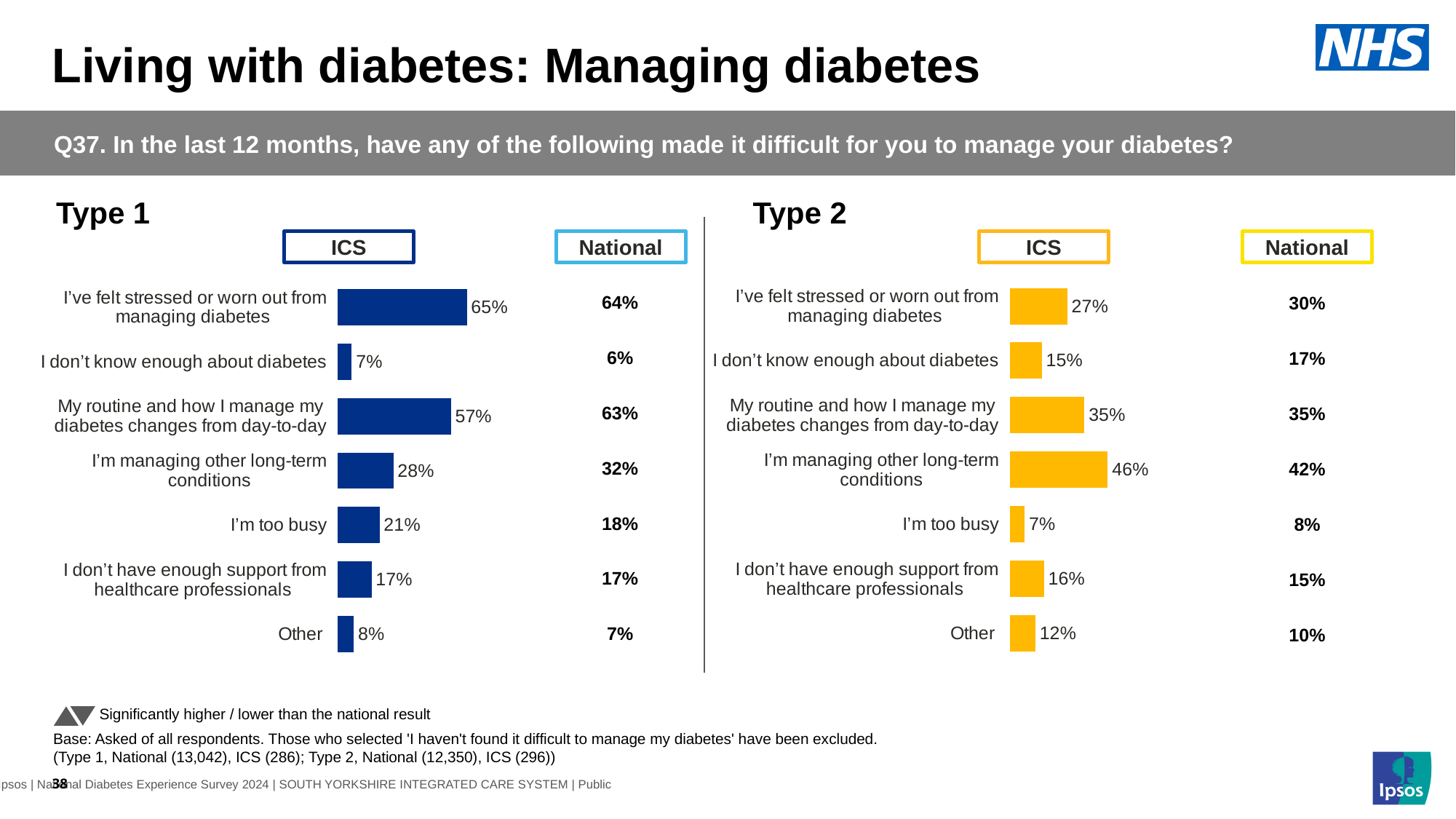
In the Type 1 chart, what is the ICS value for "I've felt stressed or worn out from managing diabetes"? 65% In the Type 2 chart, which category has the highest ICS value? I'm managing other long-term conditions In the Type 2 chart, which category has the lowest ICS value? I'm too busy In the Type 1 chart, what is the National value for "My routine and how I manage my diabetes changes from day-to-day"? 63% What colour are the ICS bars in the Type 2 chart? yellow What type of chart is used for the Type 2 ICS results? bar chart In the Type 2 chart, what is the ICS value for "I'm managing other long-term conditions"? 46% In the Type 2 chart, is the ICS value for "I've felt stressed or worn out from managing diabetes" larger or smaller than the National value? smaller In the Type 2 chart, what is the National value for "I'm too busy"? 8% How many categories are shown in the Type 1 chart? 7 In the Type 1 chart, what is the difference between the ICS and National values for "I'm too busy"? 3 percentage points In the Type 1 chart, which category has the highest ICS value? I've felt stressed or worn out from managing diabetes